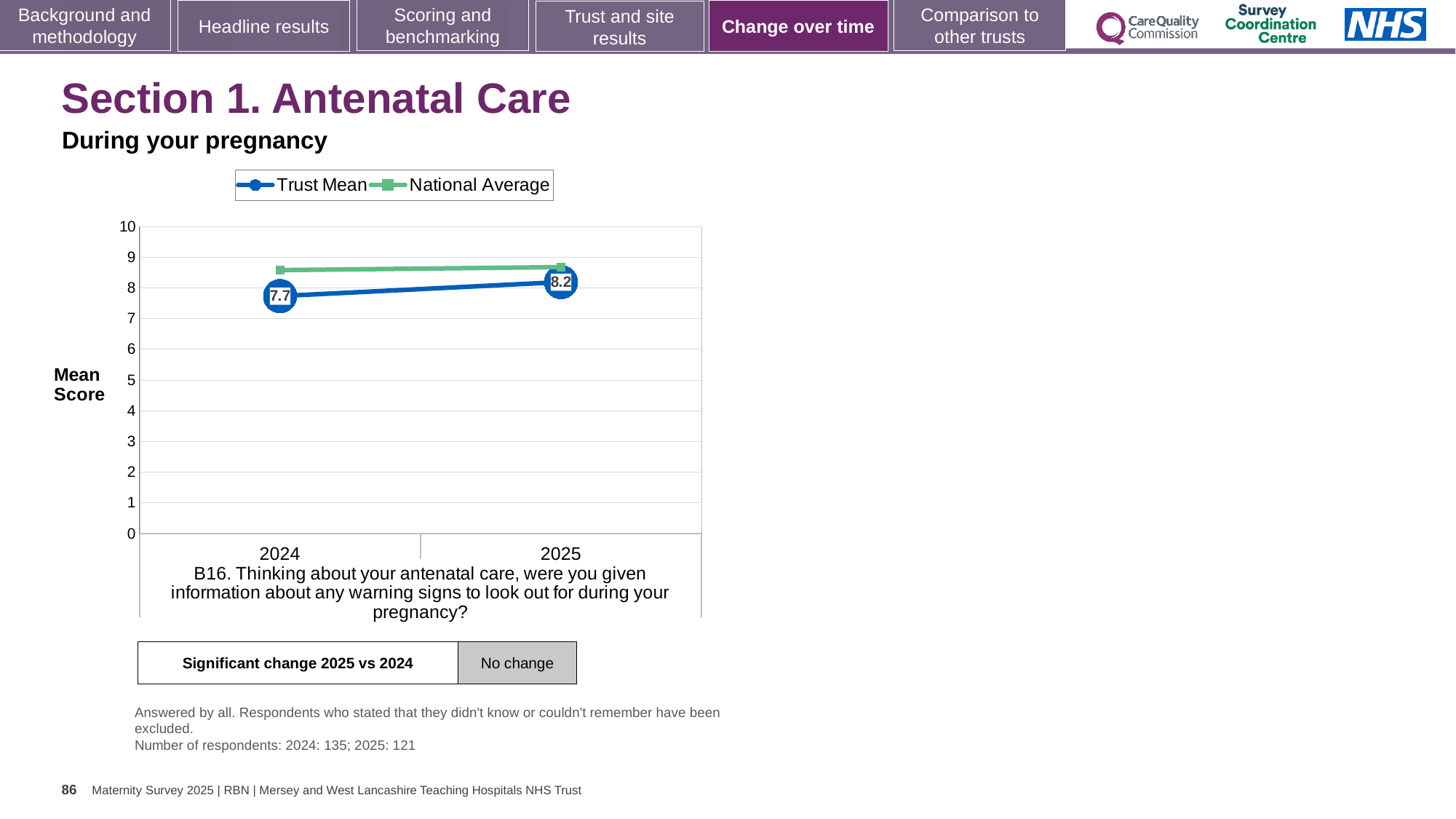
What are the two series named in the legend? Trust Mean and National Average Is the National Average value for 2024 greater or less than 8? greater What is the Trust Mean value for 2025? 8.2 In 2024, which is higher, the Trust Mean or the National Average? National Average Does the Trust Mean rise or fall from 2024 to 2025? rise What is the Trust Mean value for 2024? 7.7 Which year has the higher Trust Mean, 2024 or 2025? 2025 By how much did the Trust Mean change from 2024 to 2025? 0.5 What is the label on the y axis of the chart? Mean Score What kind of chart is shown on the slide? line chart How many series does the legend list? 2 How many years are plotted on the x axis? 2